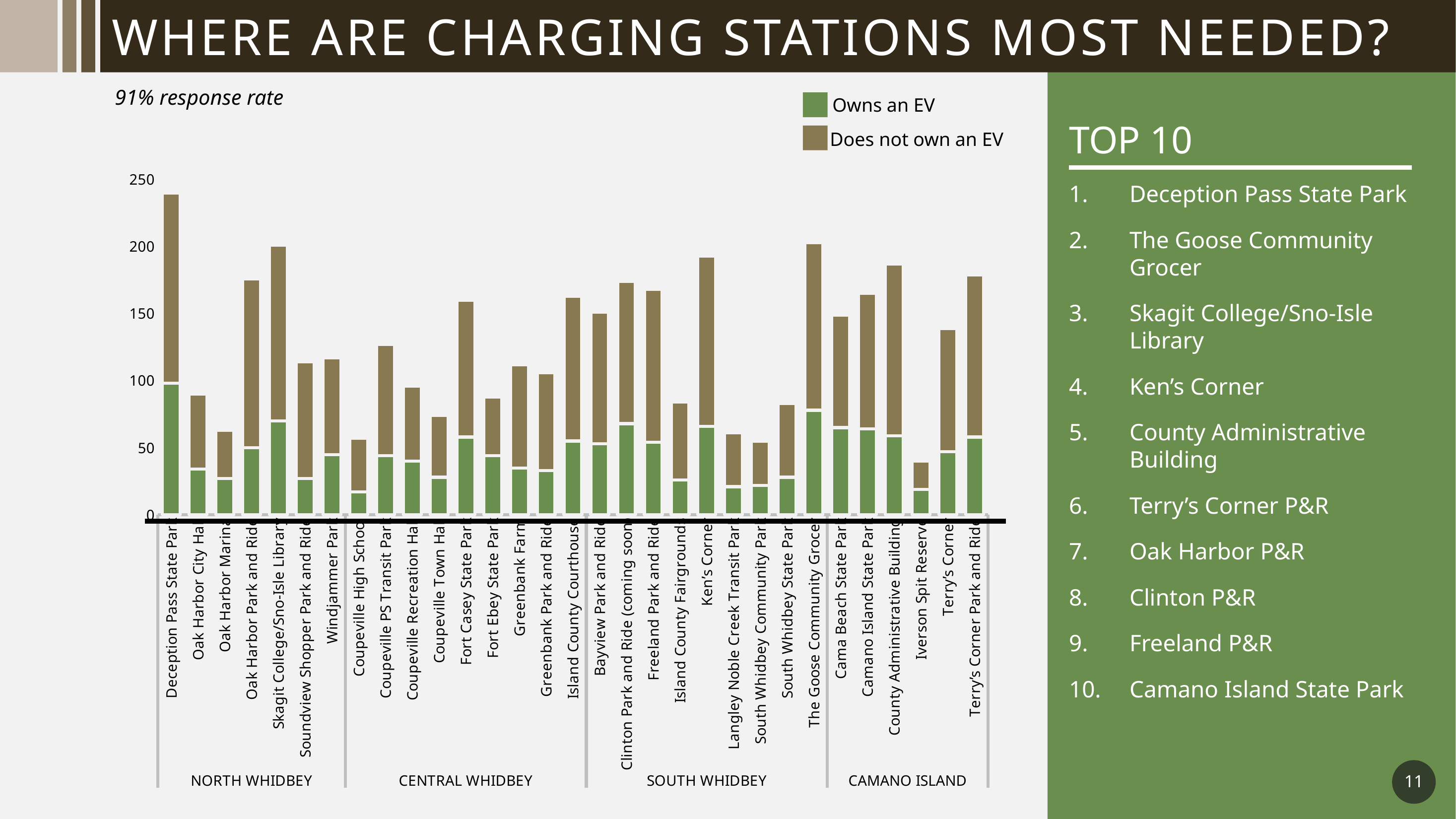
Is the total bar for Oak Harbor Park and Ride greater or less than 150? greater What response rate is stated above the chart? 91% response rate What are the two series named in the legend? Owns an EV; Does not own an EV How many series does the legend list? 2 Which location has the tallest total bar? Deception Pass State Park How many locations are plotted in the chart? 31 How many regional groups are the locations divided into along the x axis? 4 Is the total bar for Iverson Spit Reserve greater or less than 50? less What kind of chart is shown on the slide? Stacked bar chart Is the total bar for Deception Pass State Park greater or less than 200? greater Which has the taller total bar, Ken's Corner or Langley Noble Creek Transit Park? Ken's Corner Which location has the shortest total bar? Iverson Spit Reserve